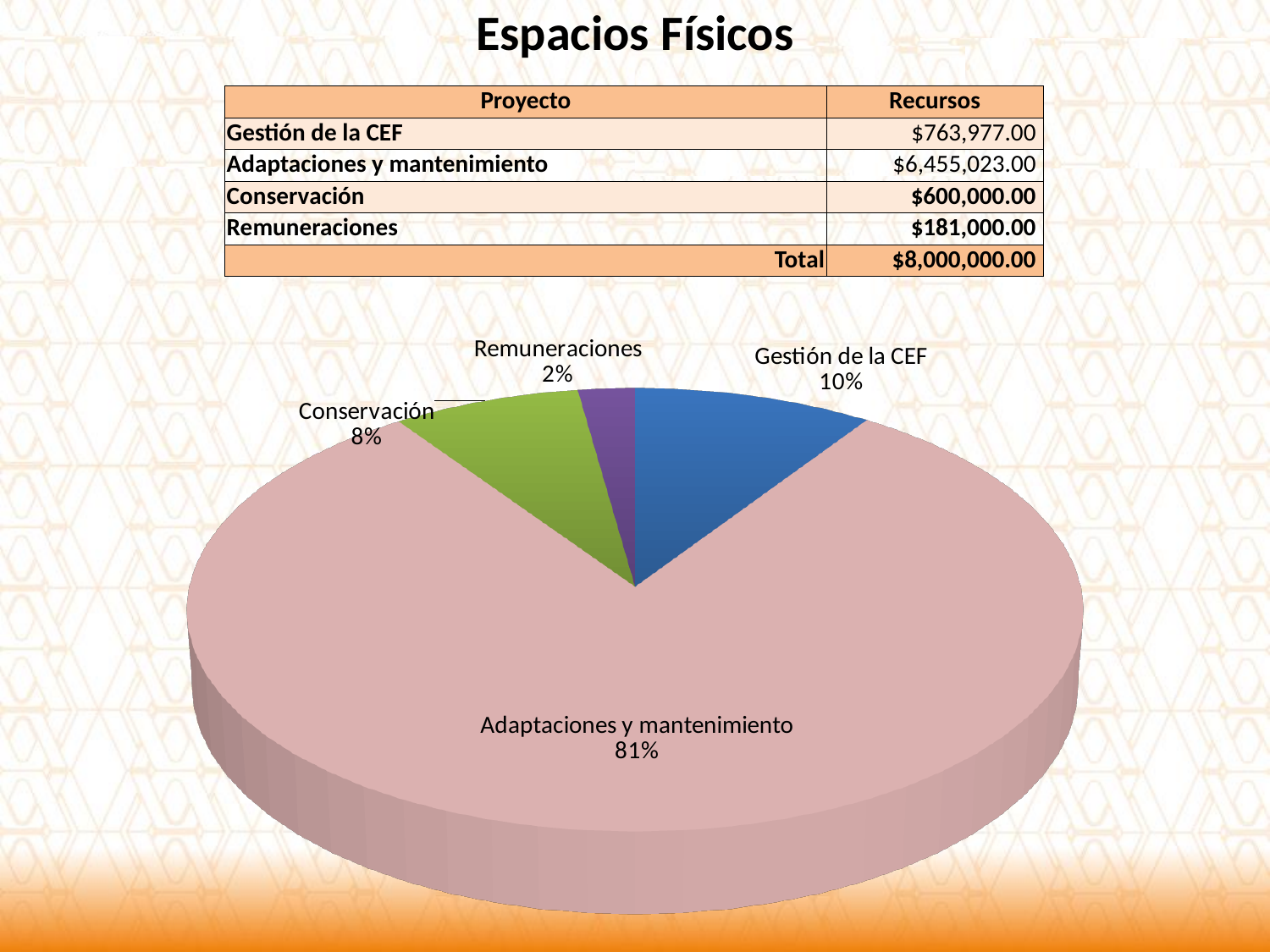
How many slices does the pie chart have? 4 Which category has the largest slice of the pie? Adaptaciones y mantenimiento Which slice is larger, Gestión de la CEF or Conservación? Gestión de la CEF What is the difference in percentage points between the Adaptaciones y mantenimiento slice and the Gestión de la CEF slice? 71% What share of the pie does Remuneraciones represent? 2% What colour is the Conservación slice of the pie? Green What share of the pie does Gestión de la CEF represent? 10% Which category has the smallest slice of the pie? Remuneraciones What share of the pie does Conservación represent? 8% What is the title shown at the top of the slide? Espacios Físicos What kind of chart is shown on the slide? Pie chart